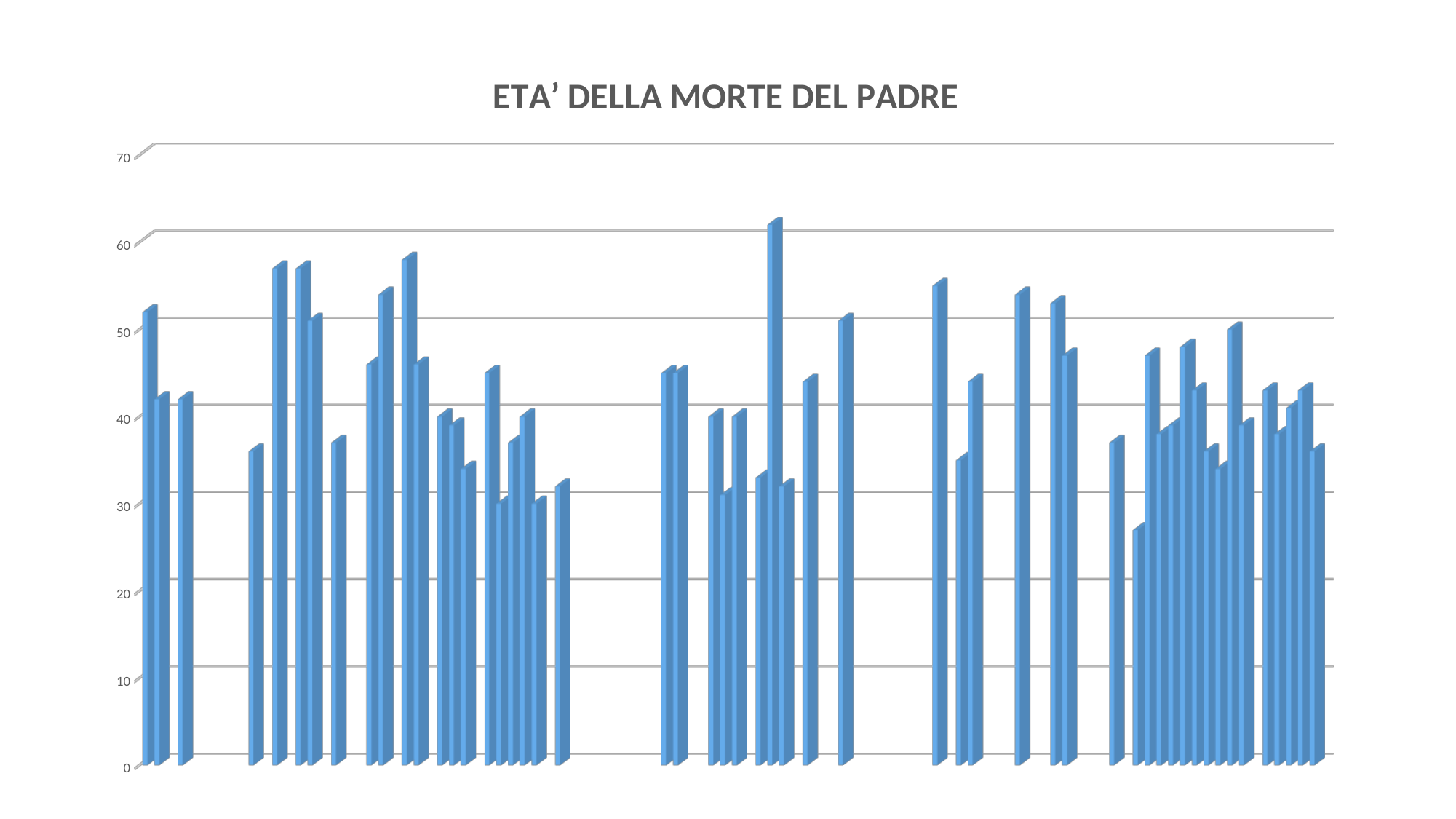
Does any bar in the chart reach a value greater than 70? No What is the title of the chart? ETA' DELLA MORTE DEL PADRE Is the value of the shortest bar in the chart greater or less than 30? less What kind of chart is shown on the slide? bar chart What is the highest value labelled on the vertical axis of the chart? 70 Is the value of the tallest bar in the chart greater or less than 60? greater